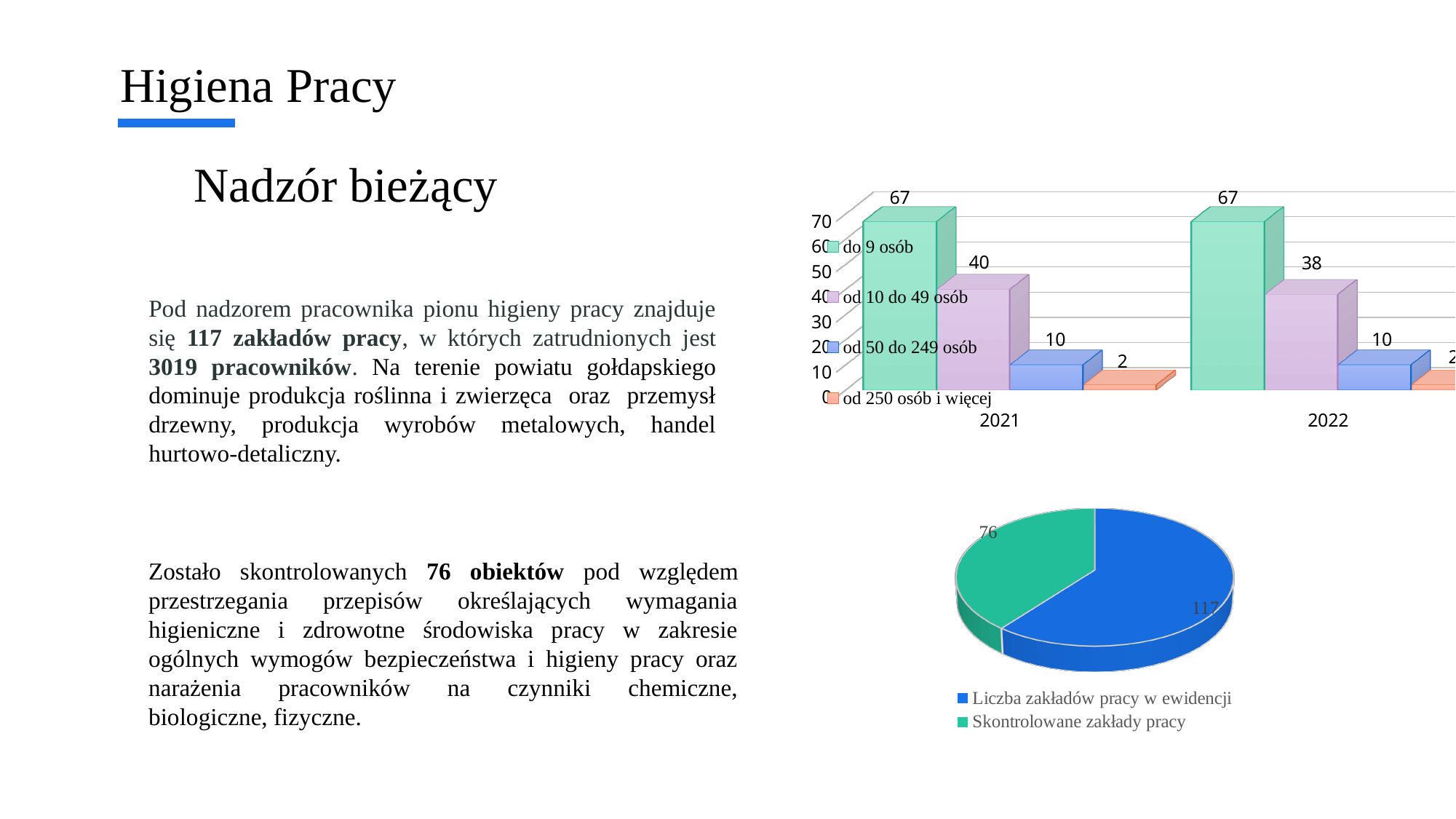
In the bar chart at the top right, what is the value for 'do 9 osób' in 2021? 67 What kind of chart is shown at the top right of the slide? bar chart In the bar chart at the top right, what is the value for 'od 50 do 249 osób' in 2021? 10 In the pie chart at the bottom right, what is the difference between 'Liczba zakładów pracy w ewidencji' and 'Skontrolowane zakłady pracy'? 41 How many years are shown on the x axis of the bar chart at the top right? 2 In the pie chart at the bottom right, which slice is larger: 'Liczba zakładów pracy w ewidencji' or 'Skontrolowane zakłady pracy'? Liczba zakładów pracy w ewidencji In the bar chart at the top right, what is the value for 'od 10 do 49 osób' in 2022? 38 In the pie chart at the bottom right, what is the value for 'Skontrolowane zakłady pracy'? 76 How many series does the legend of the bar chart at the top right list? 4 In the bar chart at the top right, by how much did the value for 'od 10 do 49 osób' change from 2021 to 2022? 2 In the bar chart at the top right, which series has the highest value in 2022? do 9 osób In the bar chart at the top right, what is the value for 'od 250 osób i więcej' in 2021? 2